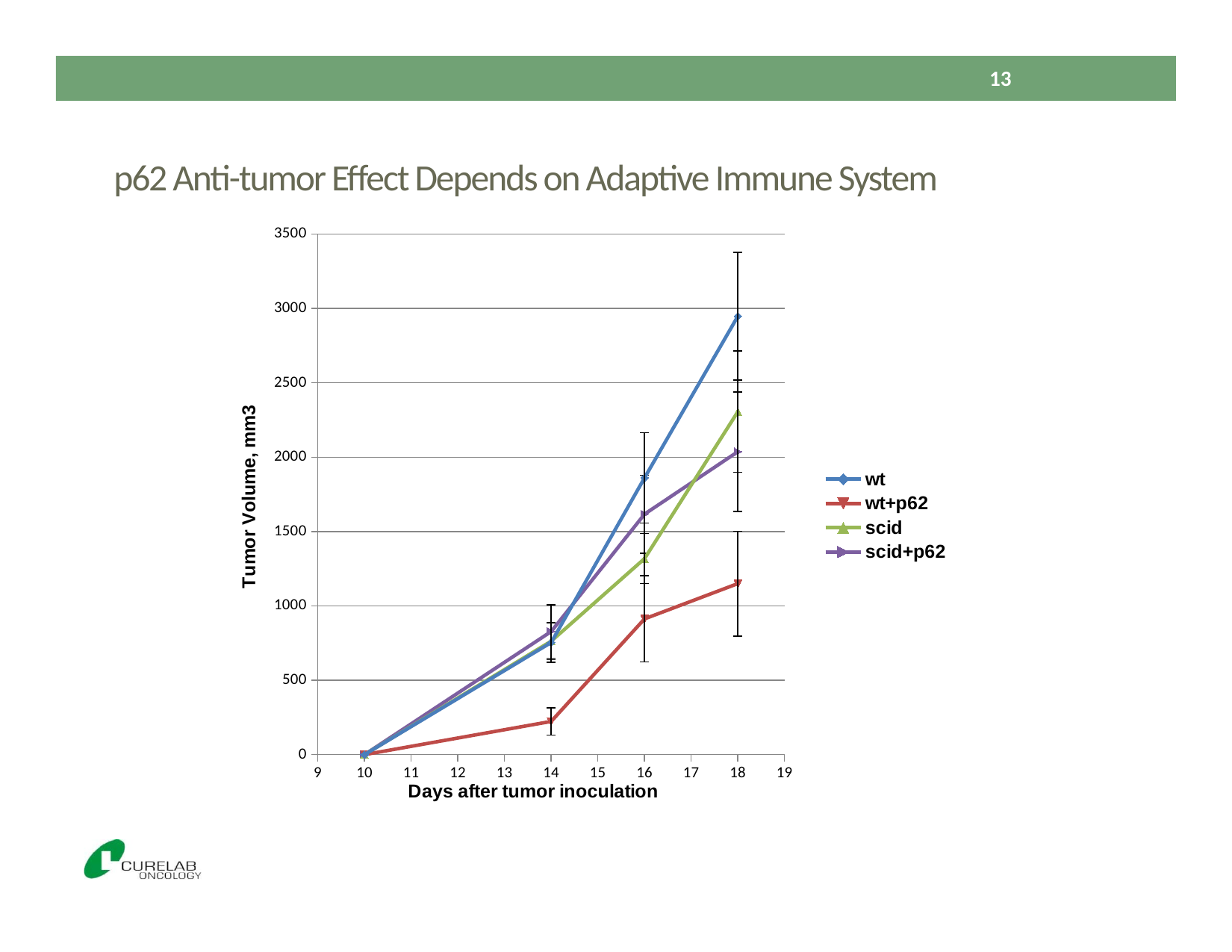
How many data points are plotted for the wt series? 4 What kind of chart is shown on the slide? line chart Which series has the highest tumor volume at day 18? wt How many series does the legend list? 4 What is the label of the y axis? Tumor Volume, mm3 At day 18, which series has the larger tumor volume, wt or scid? wt At day 16, which series has the larger tumor volume, scid or scid+p62? scid+p62 Does the tumor volume for the wt series rise or fall as days after tumor inoculation increase? rise Is the tumor volume for wt+p62 at day 18 greater or less than 1500? less Is the tumor volume for wt at day 18 greater or less than 2500? greater Which series has the lowest tumor volume at day 18? wt+p62 Is the tumor volume for wt+p62 at day 14 greater or less than 500? less